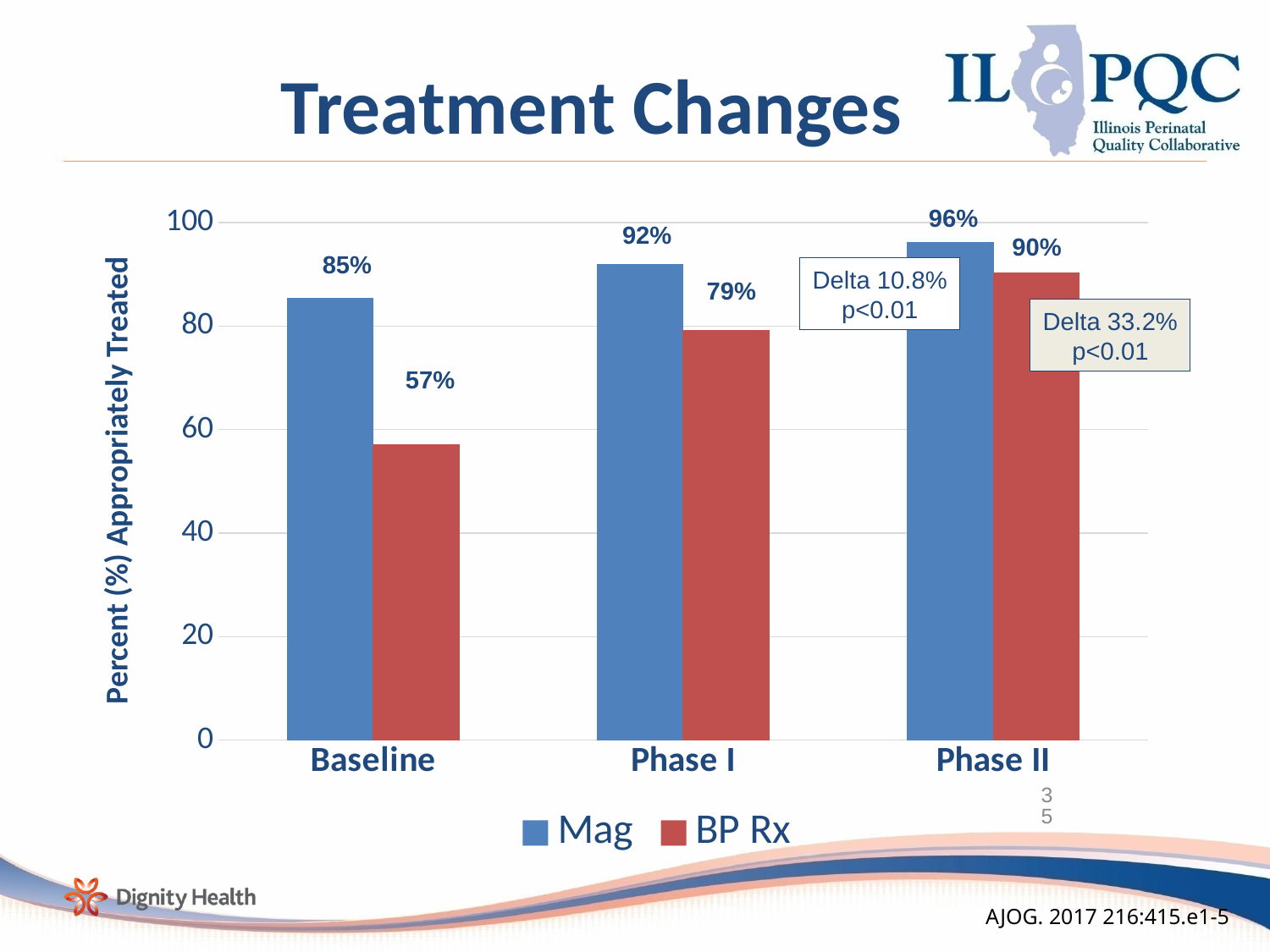
What is the difference between the Mag and BP Rx values at Baseline? 28% What kind of chart is shown? bar chart Do the BP Rx values rise or fall from Baseline to Phase II? rise Which phase has the highest Mag value? Phase II Is the value for BP Rx at Baseline greater or less than 60? less Which is larger at Phase I, Mag or BP Rx? Mag What is the value for BP Rx at Phase I? 79% How many categories are shown on the x axis? 3 What is the value for Mag at Baseline? 85% Which phase has the lowest BP Rx value? Baseline What is the value for BP Rx at Phase II? 90% How many series does the legend list? 2